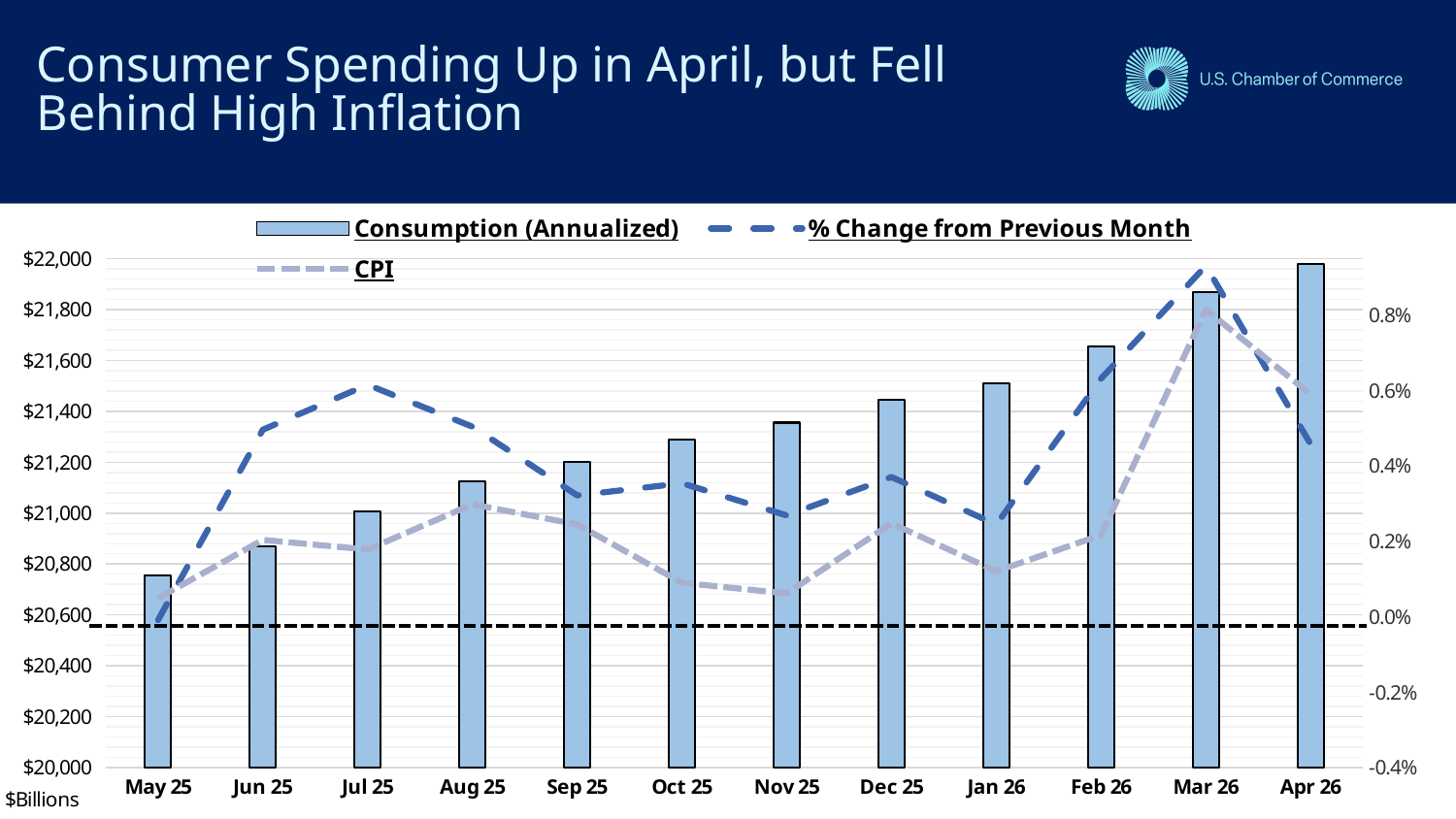
Is the Consumption (Annualized) value for Aug 25 greater or less than $21,000? greater What kind of chart is shown on the slide? A combined bar and line chart Which month has the lowest Consumption (Annualized) bar? May 25 Is the % Change from Previous Month value for Mar 26 greater or less than 0.8%? greater Which is larger, the Consumption (Annualized) bar for Mar 26 or for Feb 26? Mar 26 What unit is shown for the left axis of the chart? $Billions How many months are shown on the x axis? 12 Is the Consumption (Annualized) value for Apr 26 greater or less than $21,800? greater How many series does the legend list? 3 Do the Consumption (Annualized) bars generally rise or fall from May 25 to Apr 26? Rise Which month has the highest % Change from Previous Month value? Mar 26 Which month has the highest Consumption (Annualized) bar? Apr 26